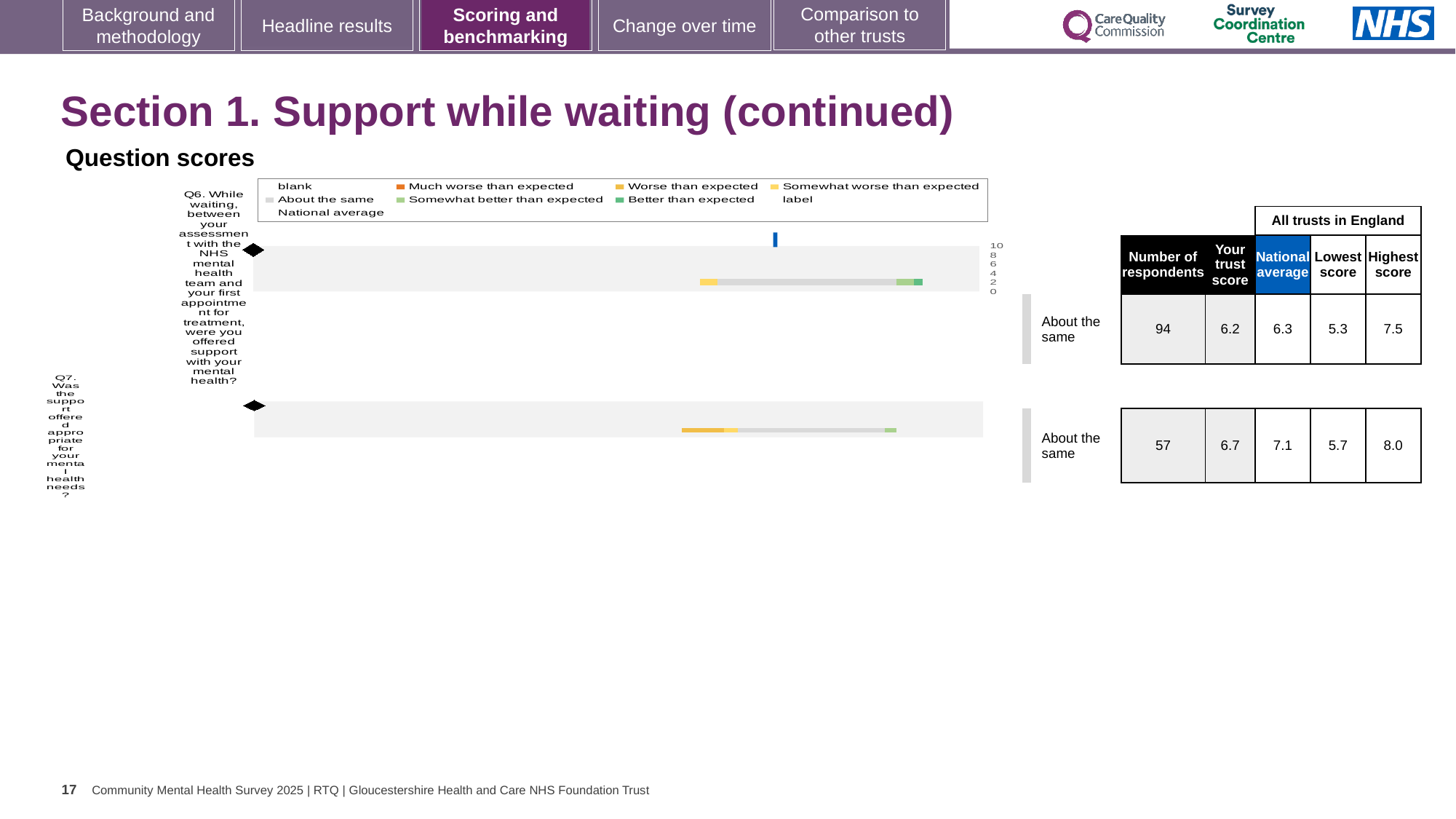
What type of chart is used to show the question scores on this slide? Bar chart Which question has the higher 'Your trust score', Q6 or Q7? Q7 What is the difference between the national average and the trust score for Q6? 0.1 Which is larger for Q6: the trust score or the national average? National average What benchmark category is shown for both Q6 and Q7? About the same What is the national average score for Q7 (was the support offered appropriate for your mental health needs)? 7.1 What is the 'Your trust score' value for Q6 (support with your mental health while waiting)? 6.2 What is the lowest score among all trusts in England for Q7? 5.7 What is the difference between the highest score and the lowest score for Q7? 2.3 How many respondents answered Q6? 94 How many questions are plotted in the question scores chart? 2